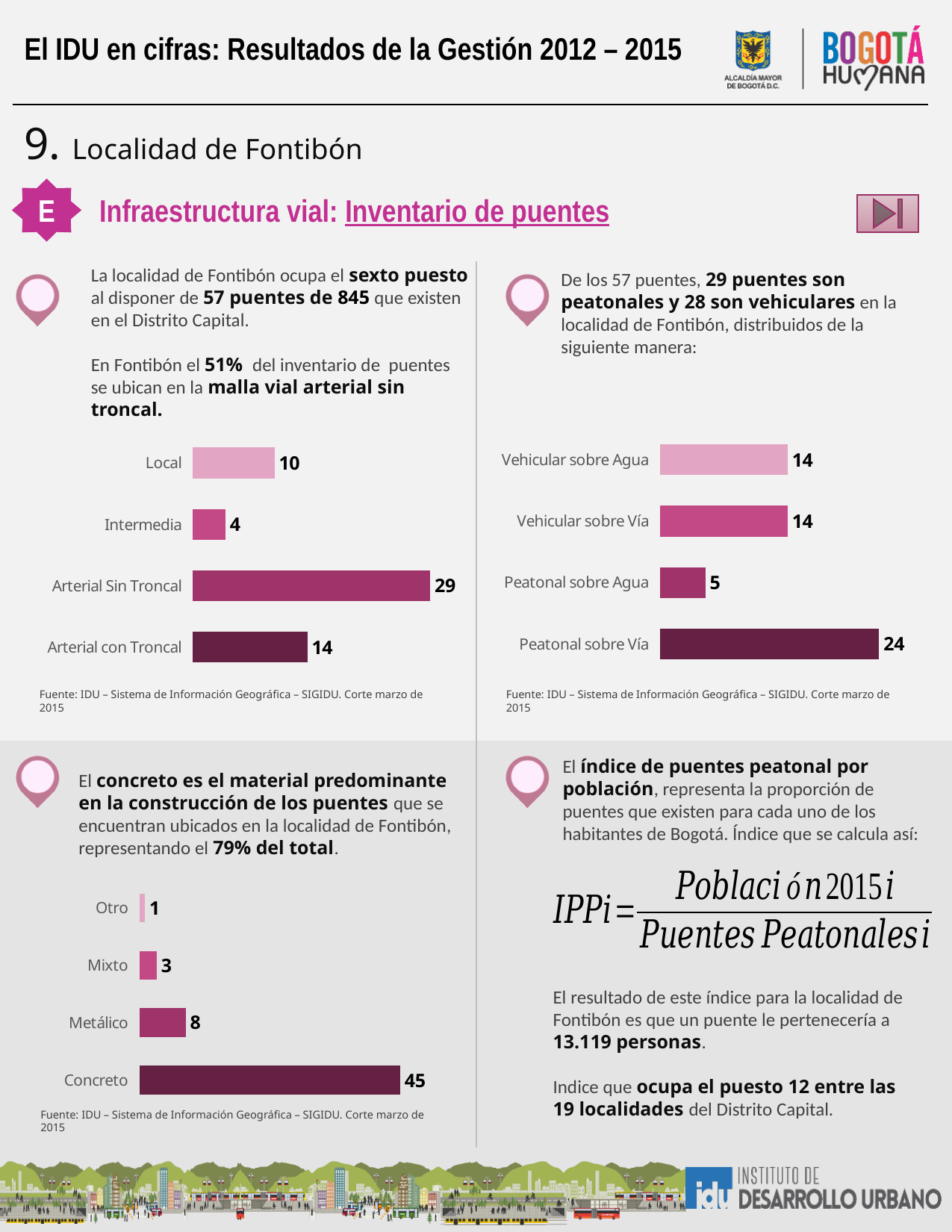
In the bottom-left chart, what is the difference between Concreto and Metálico? 37 What kind of chart is the bottom-left chart? Bar chart In the top-right chart, which is larger, Vehicular sobre Agua or Peatonal sobre Agua? Vehicular sobre Agua In the bottom-left chart, what is the value for Concreto? 45 How many categories does the top-left chart show? 4 In the top-right chart, which category has the highest value? Peatonal sobre Vía In the top-right chart, what is the value for Peatonal sobre Vía? 24 In the top-left chart, what is the difference between Arterial Sin Troncal and Arterial con Troncal? 15 In the bottom-left chart, which category has the lowest value? Otro In the top-left chart, what is the value for Arterial Sin Troncal? 29 In the top-right chart, what is the value for Peatonal sobre Agua? 5 In the top-left chart, which category has the lowest value? Intermedia